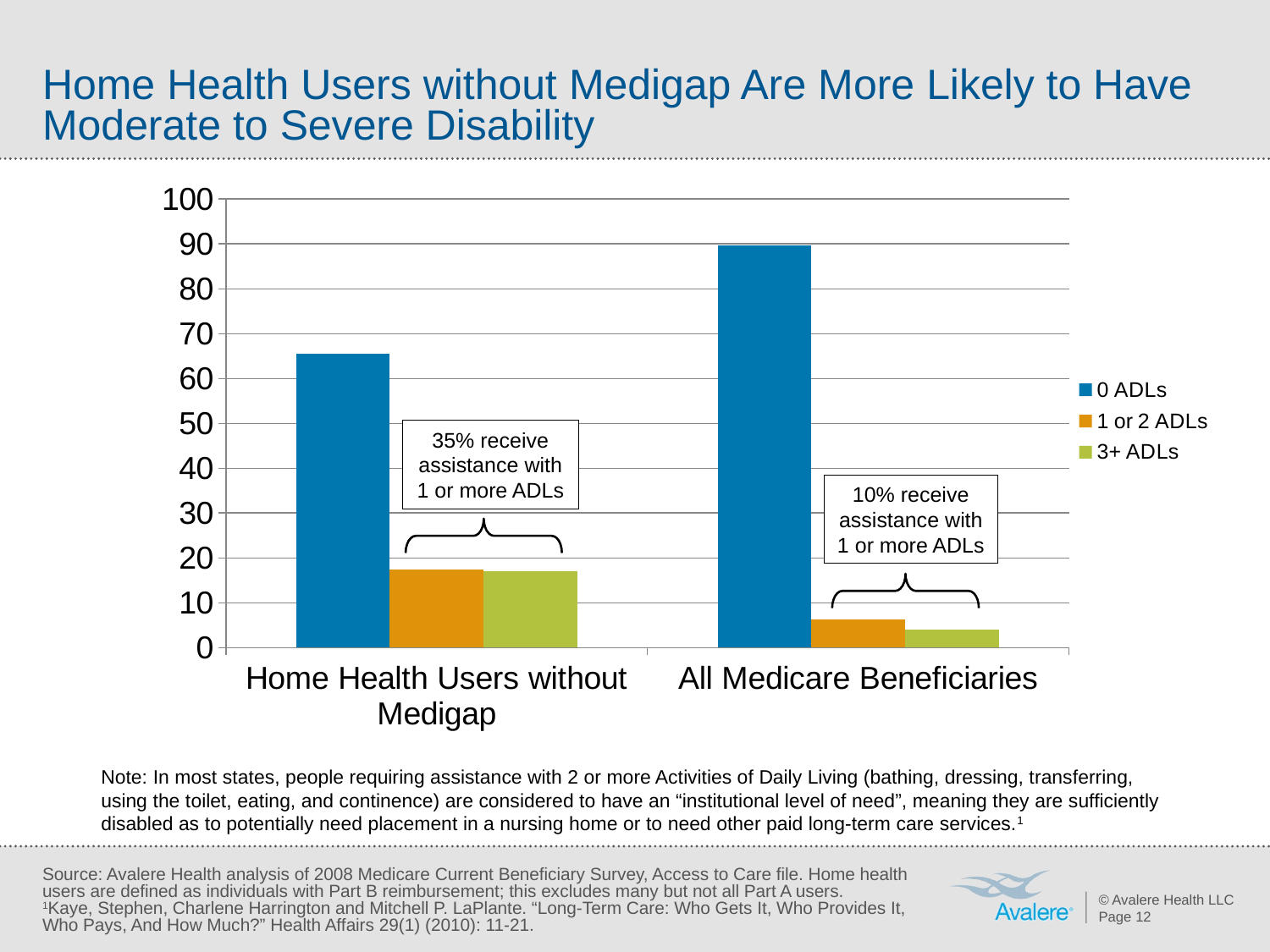
Is the value for 0 ADLs among Home Health Users without Medigap greater or less than 60? greater What kind of chart is shown on the slide? bar chart Which category has the higher value for 3+ ADLs: Home Health Users without Medigap or All Medicare Beneficiaries? Home Health Users without Medigap Is the value for 1 or 2 ADLs among Home Health Users without Medigap greater or less than 20? less Is the value for 0 ADLs among All Medicare Beneficiaries greater or less than 80? greater According to the annotation on the chart, what percentage of Home Health Users without Medigap receive assistance with 1 or more ADLs? 35% How many categories are shown on the x axis of the chart? 2 Which category has the higher value for 0 ADLs: Home Health Users without Medigap or All Medicare Beneficiaries? All Medicare Beneficiaries Which series has the lowest value for All Medicare Beneficiaries? 3+ ADLs How many series does the chart's legend list? 3 According to the annotation on the chart, what percentage of All Medicare Beneficiaries receive assistance with 1 or more ADLs? 10%